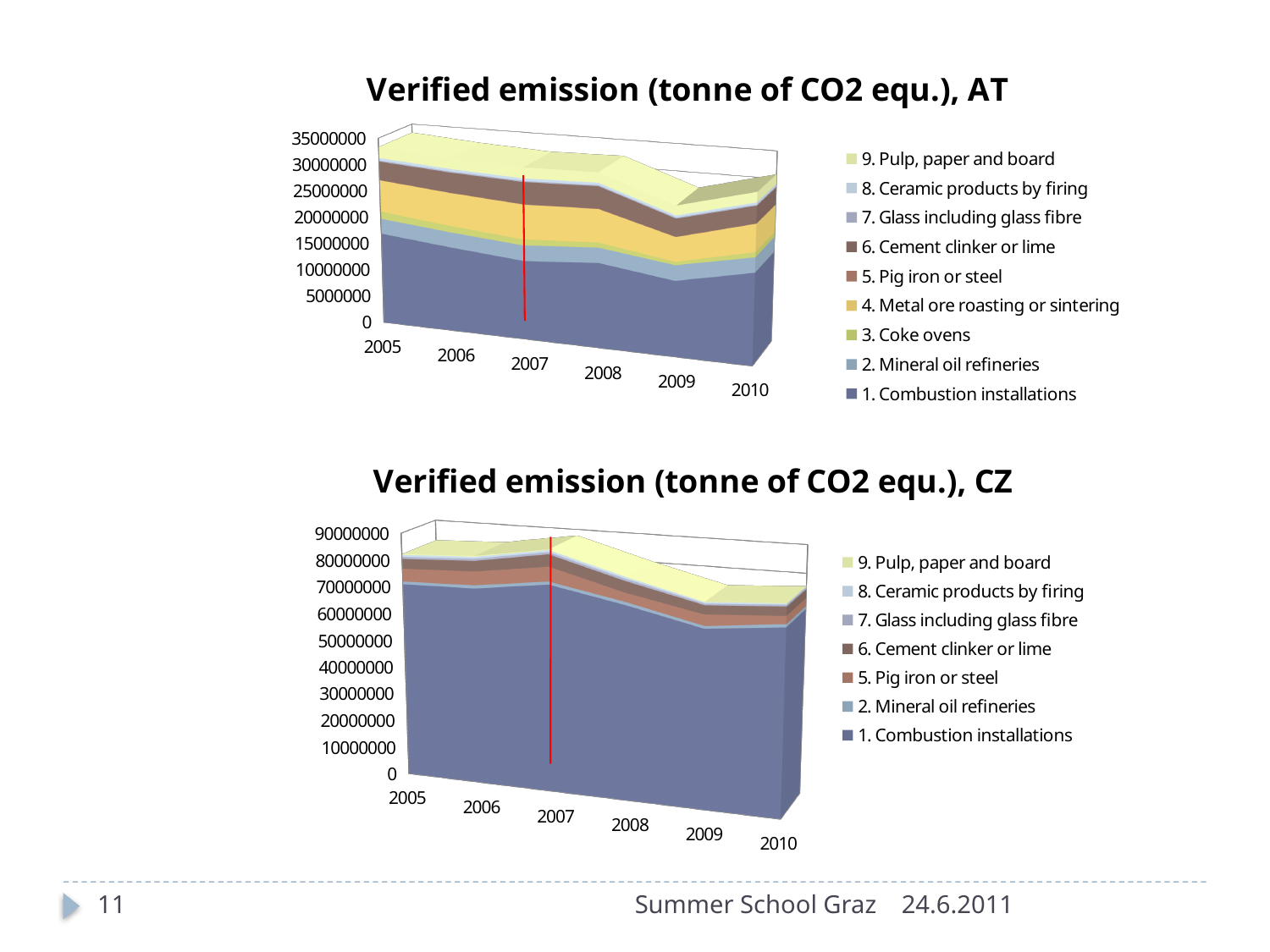
In the top chart (AT), does the total verified emission rise or fall from 2005 to 2010 overall? fall How many years are shown on the x axis of the top chart (AT)? 6 What is the first year shown on the x axis of the bottom chart (CZ)? 2005 How many series does the legend of the top chart (AT) list? 9 In the top chart (AT), is the total verified emission in 2005 greater or less than 30000000? greater How many series does the legend of the bottom chart (CZ) list? 7 In the bottom chart (CZ), does the total verified emission rise or fall from 2005 to 2010 overall? fall Which legend entry in the bottom chart (CZ) is listed last? 1. Combustion installations What type of chart is the top chart, 'Verified emission (tonne of CO2 equ.), AT'? stacked area chart